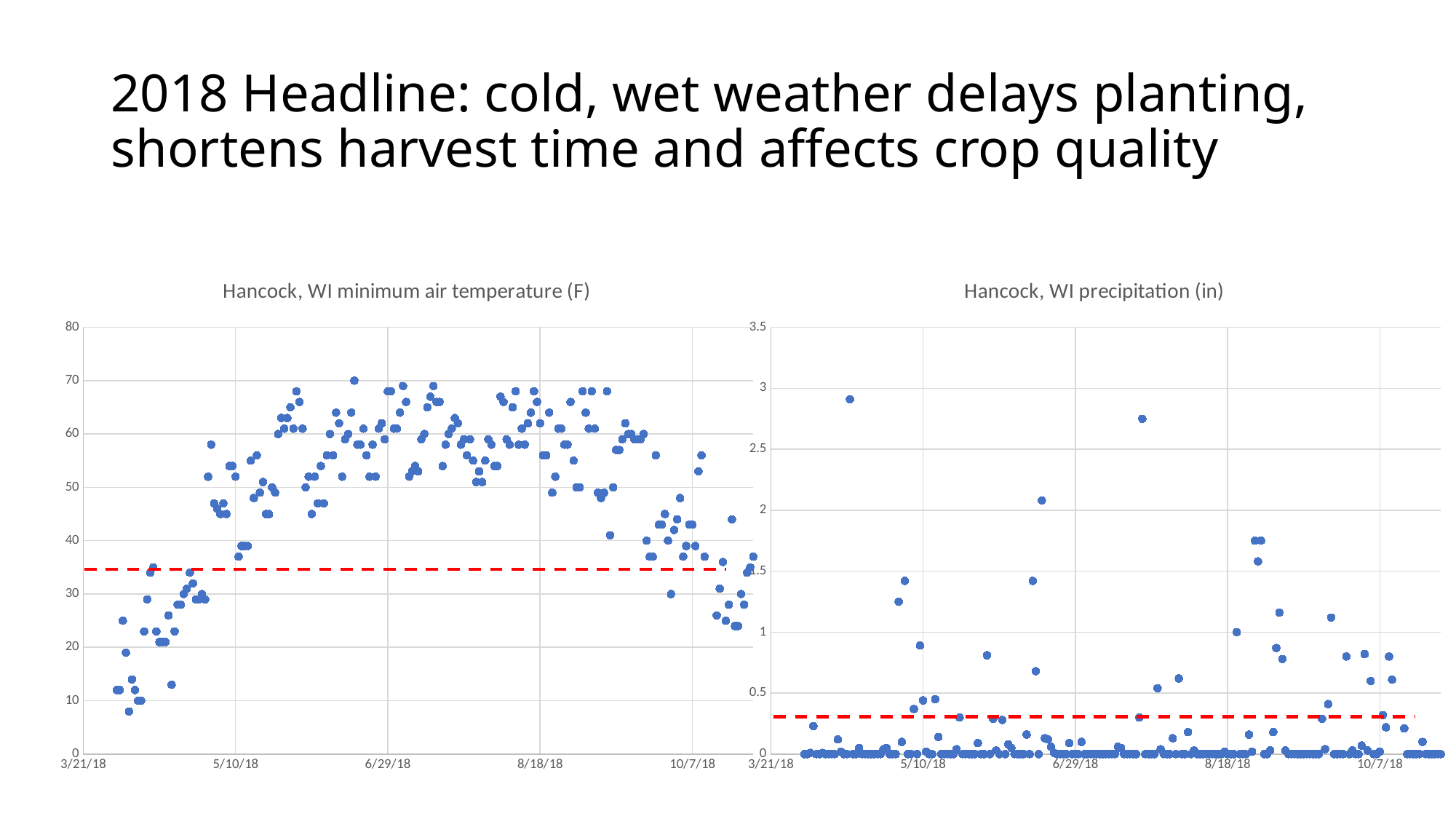
In the 'Hancock, WI precipitation (in)' chart, is the highest plotted value greater or less than 2.5? greater In the 'Hancock, WI minimum air temperature (F)' chart, is the red dashed line greater or less than 30? greater What kind of chart is the 'Hancock, WI minimum air temperature (F)' chart? scatter chart In the 'Hancock, WI minimum air temperature (F)' chart, is the lowest plotted value greater or less than 10? less In the 'Hancock, WI minimum air temperature (F)' chart, do the plotted values generally rise or fall between 3/21/18 and 5/10/18? rise What kind of chart is the 'Hancock, WI precipitation (in)' chart? scatter chart What is the title of the chart on the left side of the slide? Hancock, WI minimum air temperature (F) What is the title of the chart on the right side of the slide? Hancock, WI precipitation (in) In the 'Hancock, WI minimum air temperature (F)' chart, do the plotted values generally rise or fall between 8/18/18 and 10/7/18? fall